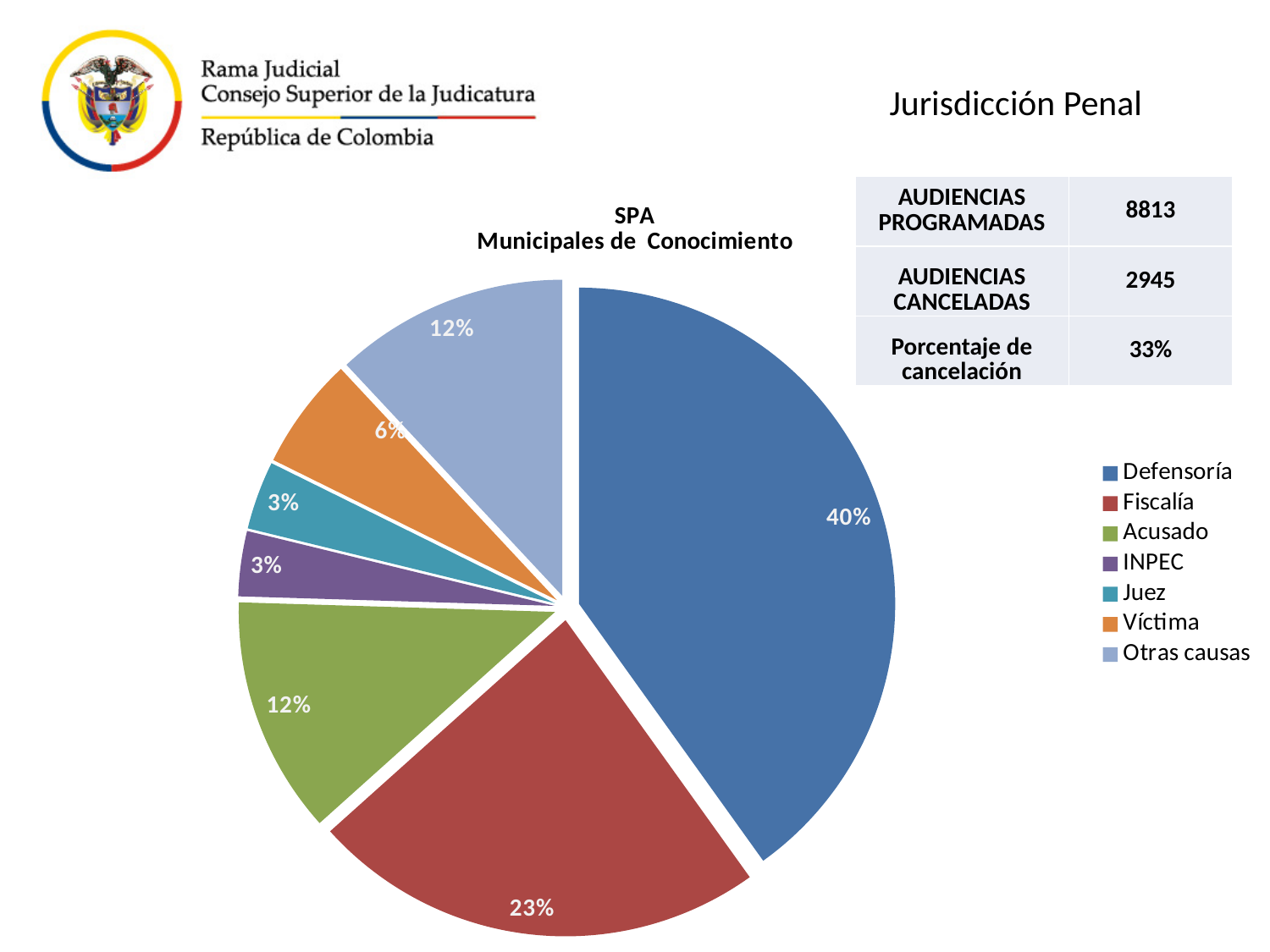
Which is larger, the share for Víctima or the share for Acusado? Acusado What share of the pie does Otras causas represent? 12% What type of chart is shown on the slide? pie chart What share of the pie does Fiscalía represent? 23% What share of the pie does Defensoría represent? 40% What share of the pie does Víctima represent? 6% What is the difference in percentage points between Defensoría and Fiscalía? 17 What is the title of the pie chart? SPA Municipales de Conocimiento How many categories does the legend list? 7 Which category has the largest slice of the pie? Defensoría What colour is the Fiscalía slice? red What share of the pie does Acusado represent? 12%